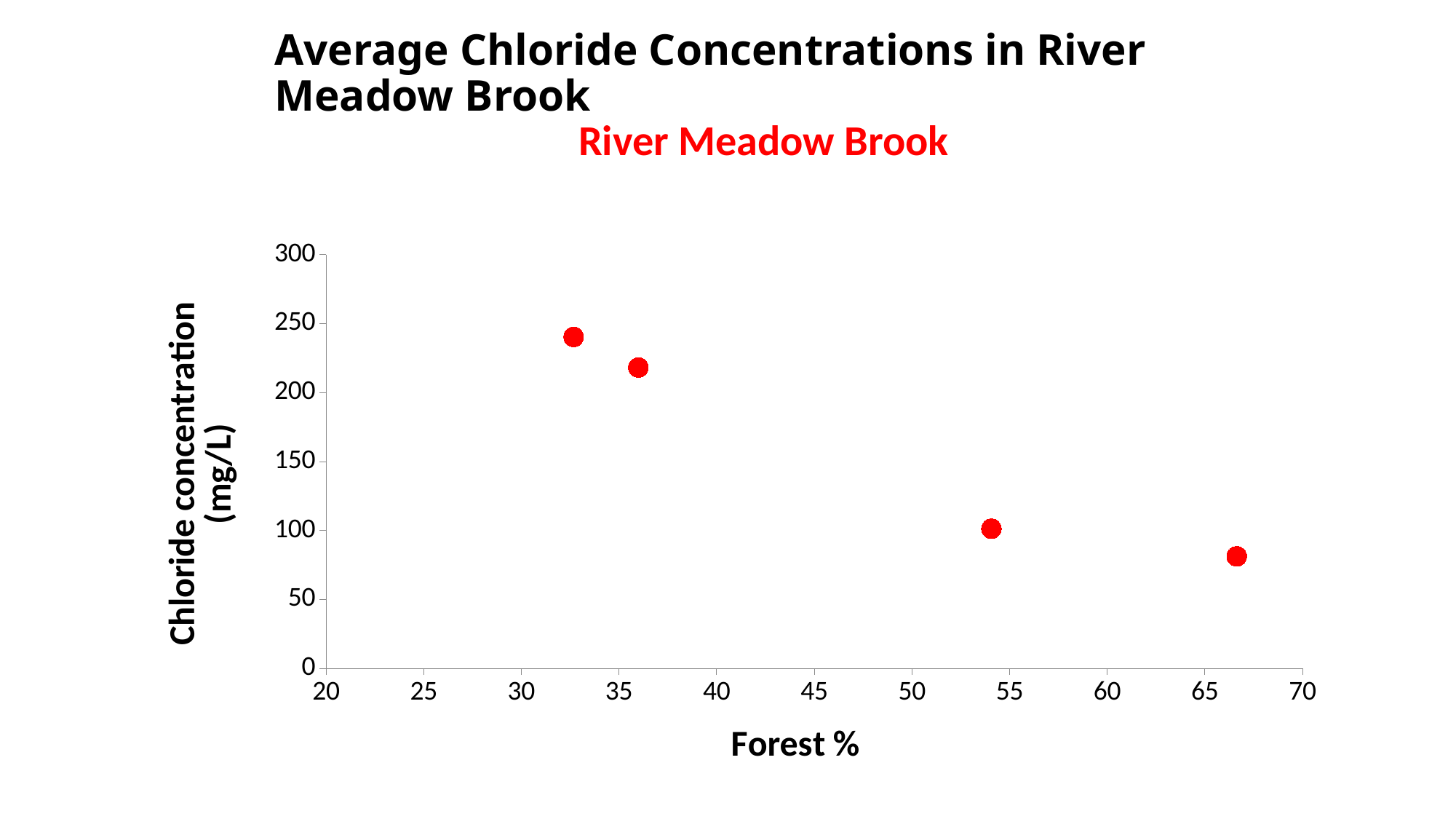
How many data points are plotted on the chart? 4 What is the label of the x axis? Forest % Is the chloride concentration for the point at about 54% forest greater or less than 150? less Which point has the highest chloride concentration: the one with the lowest Forest % or the one with the highest Forest %? the one with the lowest Forest % What kind of chart is shown on the slide? scatter chart Which point has the lowest chloride concentration: the leftmost or the rightmost? the rightmost As Forest % increases along the x axis, do the chloride concentration values rise or fall? fall Which has the higher chloride concentration: the leftmost point or the rightmost point? the leftmost point Is the chloride concentration for the point at about 36% forest greater or less than 250? less Is the chloride concentration for the rightmost point (around 67% forest) greater or less than 100? less What is the label of the y axis? Chloride concentration (mg/L)